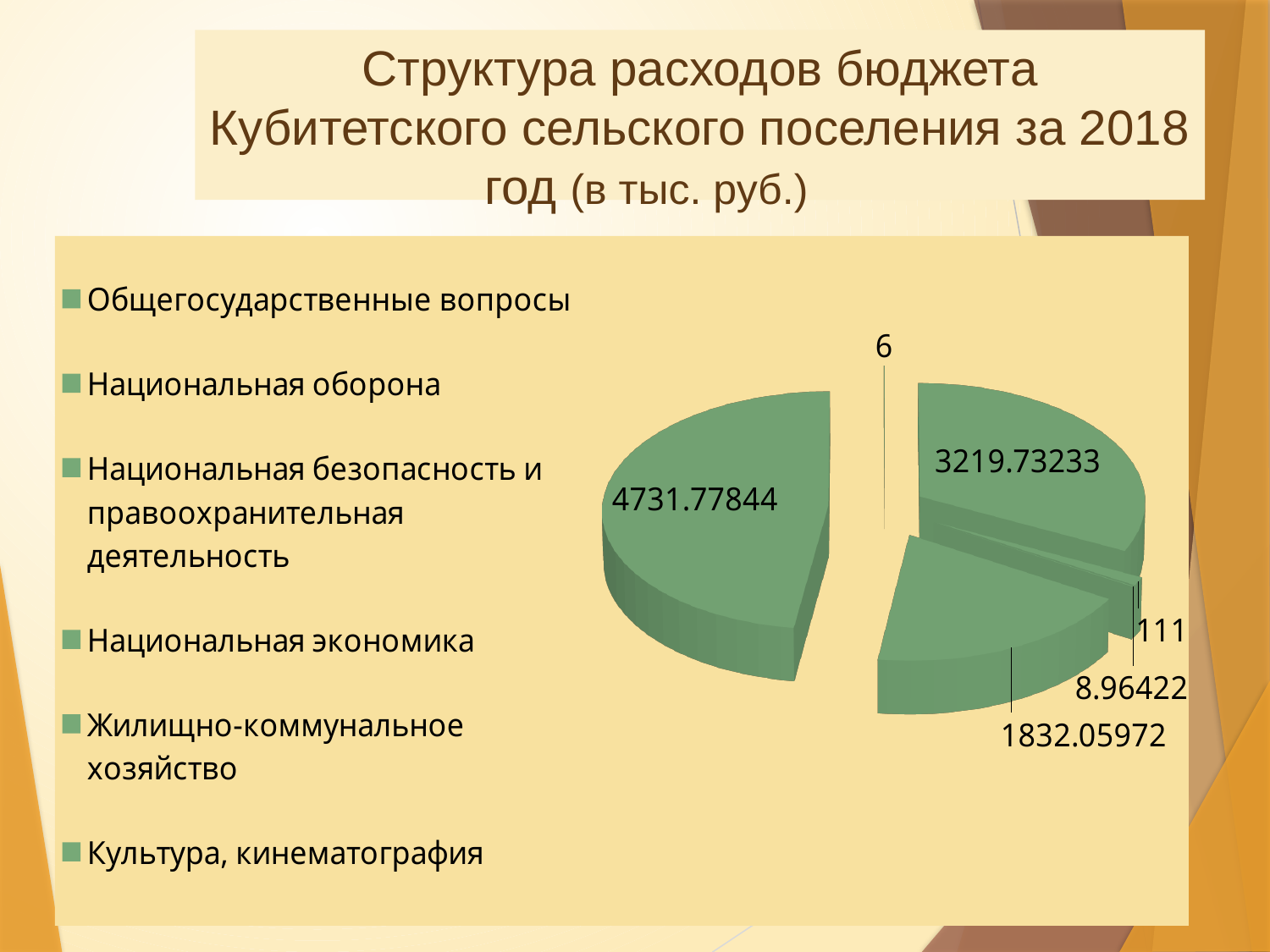
How many slices does the pie chart have? 6 What is the first entry listed in the chart's legend? Общегосударственные вопросы What is the difference between the labelled values 3219.73233 and 1832.05972? 1387.67261 How many entries does the legend of the chart list? 6 What kind of chart is shown on the slide? pie chart What is the difference between the labelled values 111 and 6? 105 Which labelled value is larger: 1832.05972 or 3219.73233? 3219.73233 What is the smallest value labelled on the pie chart? 6 Which labelled value is larger: 111 or 8.96422? 111 What is the difference between the two largest labelled values on the pie chart, 4731.77844 and 3219.73233? 1512.04611 What is the total of all the values labelled on the pie chart? 9909.53471 What is the largest value labelled on the pie chart? 4731.77844